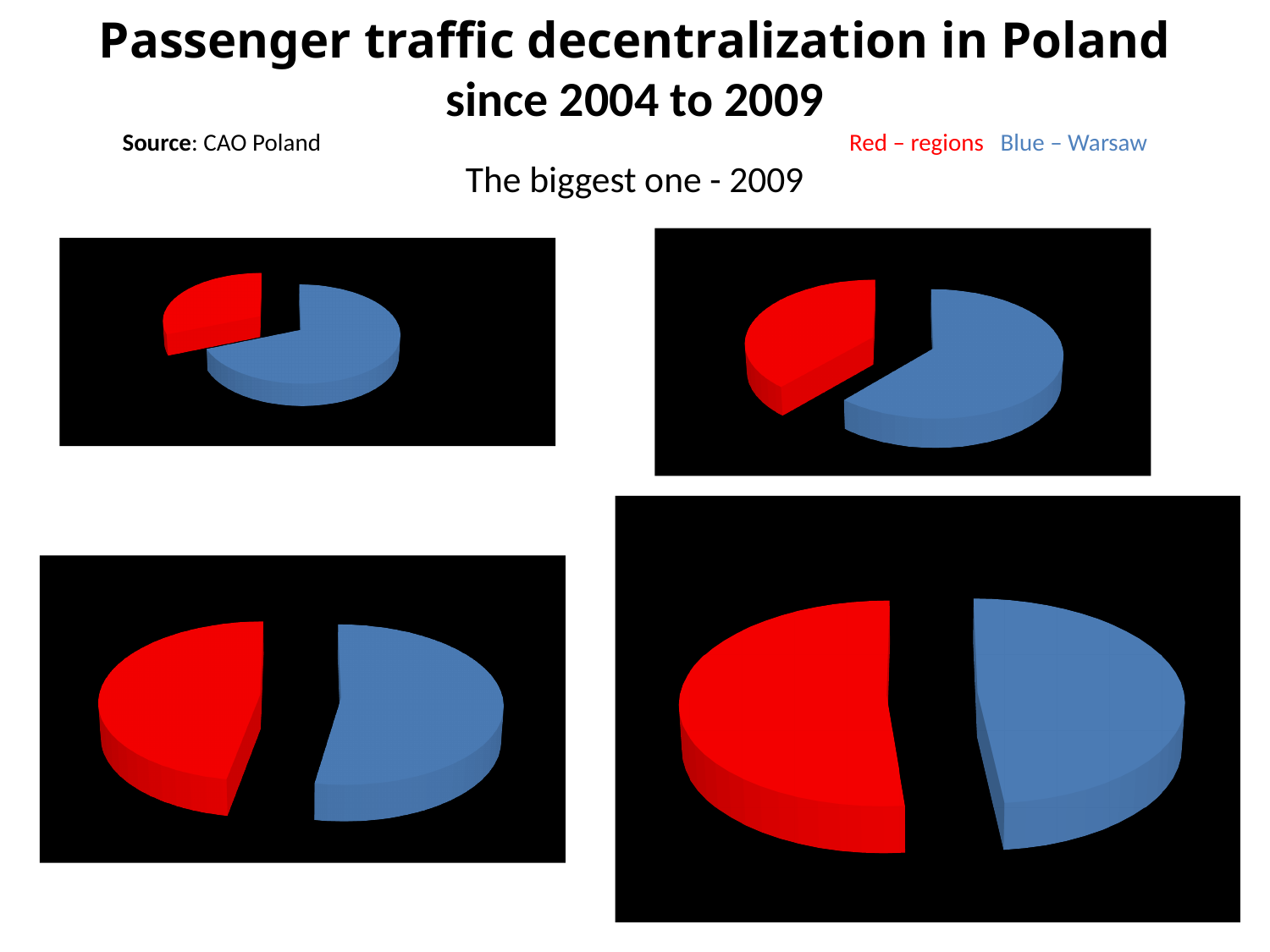
How many slices does the bottom-right pie chart have? 2 In the top-right pie chart, which slice is larger, the red (regions) or the blue (Warsaw)? Blue (Warsaw) In the top-left pie chart, which slice is larger, the red (regions) or the blue (Warsaw)? Blue (Warsaw) What kind of chart is the large bottom-right chart on the slide? Pie chart In the bottom-left pie chart, which slice is larger, the red (regions) or the blue (Warsaw)? Blue (Warsaw) According to the slide's legend, what does the blue slice in the pie charts represent? Warsaw What kind of chart is the top-left chart on the slide? Pie chart According to the slide's legend, what does the red slice in the pie charts represent? Regions How many slices does the top-left pie chart have? 2 How many pie charts are shown on the slide? 4